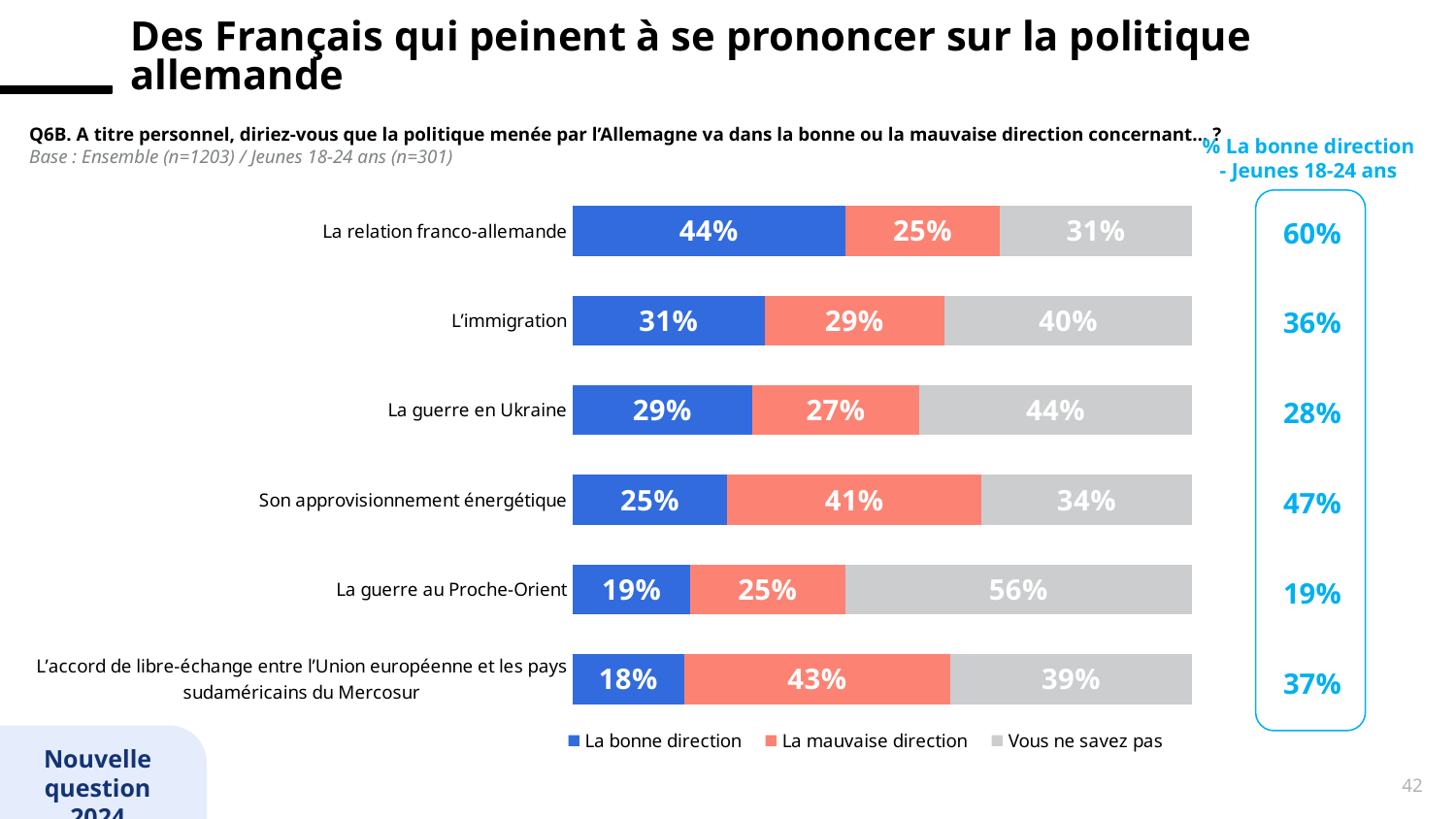
What percentage of respondents say Germany's policy on 'La relation franco-allemande' is going in the right direction ('La bonne direction')? 44% What type of chart is used on this slide? Stacked bar chart What is the 'Vous ne savez pas' value for 'La guerre au Proche-Orient'? 56% What is the '% La bonne direction - Jeunes 18-24 ans' value for 'Son approvisionnement énergétique'? 47% What is the 'La mauvaise direction' value for 'Son approvisionnement énergétique'? 41% Which category has the highest 'La bonne direction' value? La relation franco-allemande Which colour represents 'La mauvaise direction' in the chart? Salmon/orange-red How many categories are shown in the stacked bar chart? 6 Which category has the lowest 'La bonne direction' value? L'accord de libre-échange entre l'Union européenne et les pays sudaméricains du Mercosur Which is larger: the 'La mauvaise direction' value for 'L'immigration' or for 'La guerre en Ukraine'? L'immigration What is the difference between the 'Vous ne savez pas' values for 'La guerre au Proche-Orient' and 'La relation franco-allemande'? 25 percentage points How many series does the legend list? 3